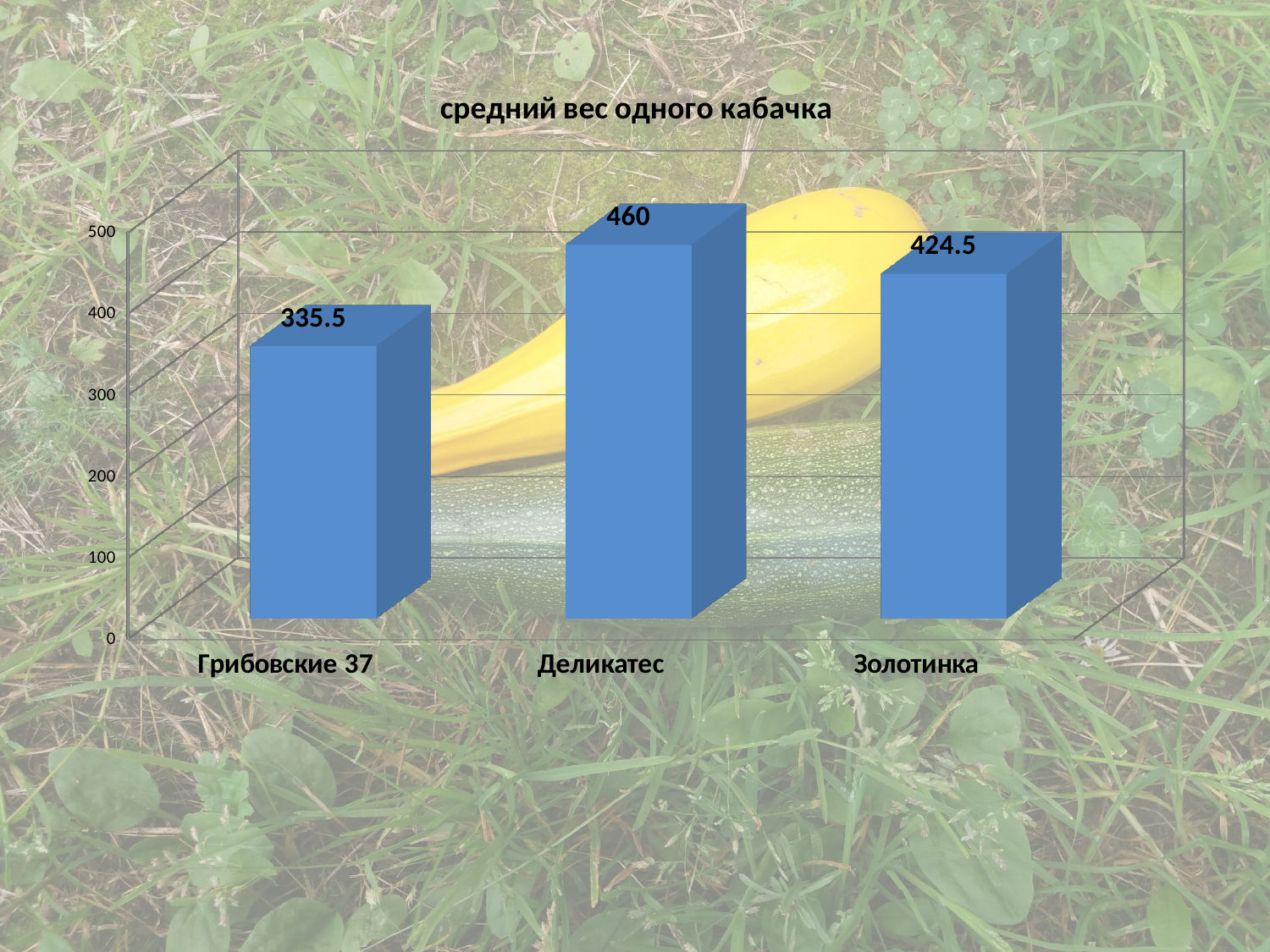
Which is larger, the value for Золотинка or the value for Грибовские 37? Золотинка Which variety has the lowest average weight of one squash? Грибовские 37 Is the value for Грибовские 37 greater or less than 400? less What is the title of the chart? средний вес одного кабачка Which variety has the highest average weight of one squash? Деликатес What is the difference between the values for Деликатес and Золотинка? 35.5 What is the value shown for Деликатес? 460 What is the difference between the values for Деликатес and Грибовские 37? 124.5 How many varieties are shown on the chart? 3 What is the average weight of one squash for Грибовские 37? 335.5 What is the value shown for Золотинка? 424.5 What kind of chart is shown on the slide? bar chart